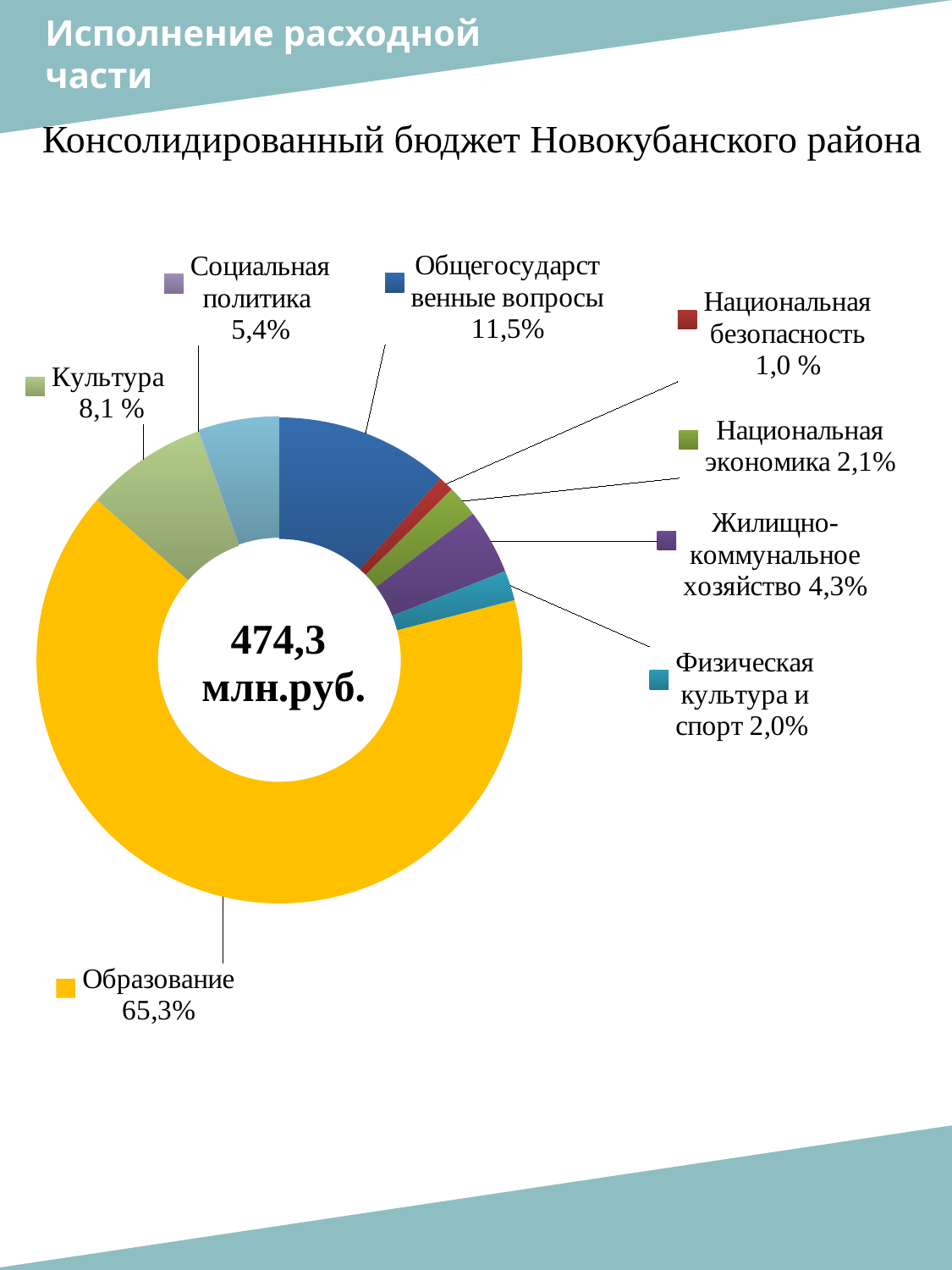
What share is shown for Общегосударственные вопросы? 11,5% What share is shown for Культура? 8,1 % Which is larger: the share for Социальная политика or the share for Жилищно-коммунальное хозяйство? Социальная политика How many categories are shown in the chart? 8 Which category has the smallest share of the budget? Национальная безопасность Which category has the largest share of the budget? Образование What total amount is printed in the centre of the chart? 474,3 млн.руб. What share is shown for Жилищно-коммунальное хозяйство? 4,3% What kind of chart is shown on the slide? Doughnut (pie) chart What is the difference in percentage points between the shares for Образование and Общегосударственные вопросы? 53,8 What colour is the segment for Образование? Yellow What share of the consolidated budget goes to Образование? 65,3%